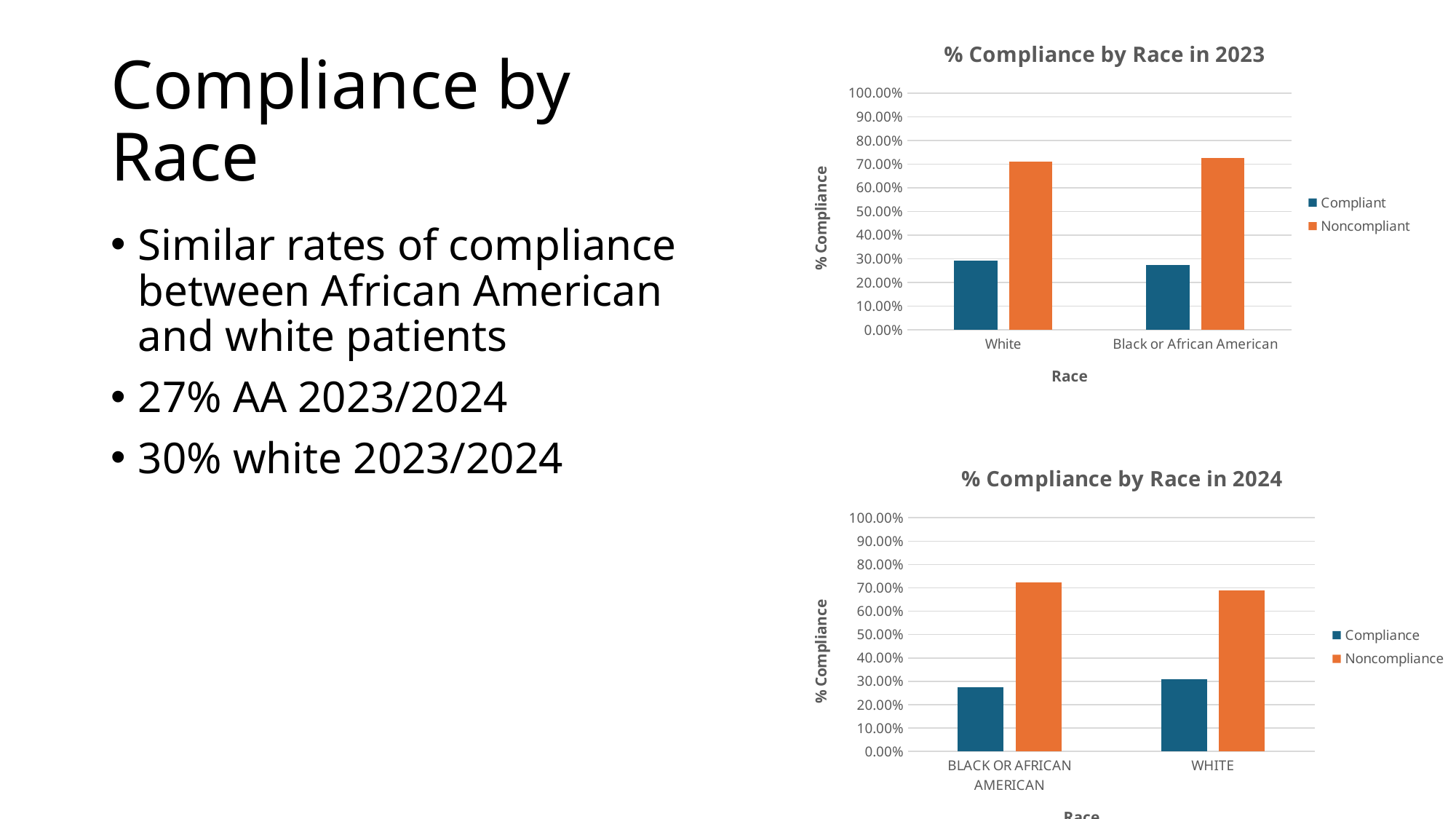
In the '% Compliance by Race in 2024' chart, which is larger for WHITE: Compliance or Noncompliance? Noncompliance What kind of chart is the '% Compliance by Race in 2023' chart? bar chart How many race categories are shown on the x axis of the '% Compliance by Race in 2024' chart? 2 How many series does the legend of the '% Compliance by Race in 2023' chart list? 2 In the '% Compliance by Race in 2023' chart, which is larger for White: Compliant or Noncompliant? Noncompliant What is the title of the lower chart on the slide? % Compliance by Race in 2024 In the '% Compliance by Race in 2024' chart, is the Noncompliance value for BLACK OR AFRICAN AMERICAN greater or less than 60.00%? greater In the '% Compliance by Race in 2024' chart, which series has the lowest bar for BLACK OR AFRICAN AMERICAN? Compliance In the '% Compliance by Race in 2023' chart, is the Compliant value for Black or African American greater or less than 40.00%? less What is the y-axis label of the '% Compliance by Race in 2023' chart? % Compliance In the '% Compliance by Race in 2023' chart, is the Noncompliant value for White greater or less than 60.00%? greater